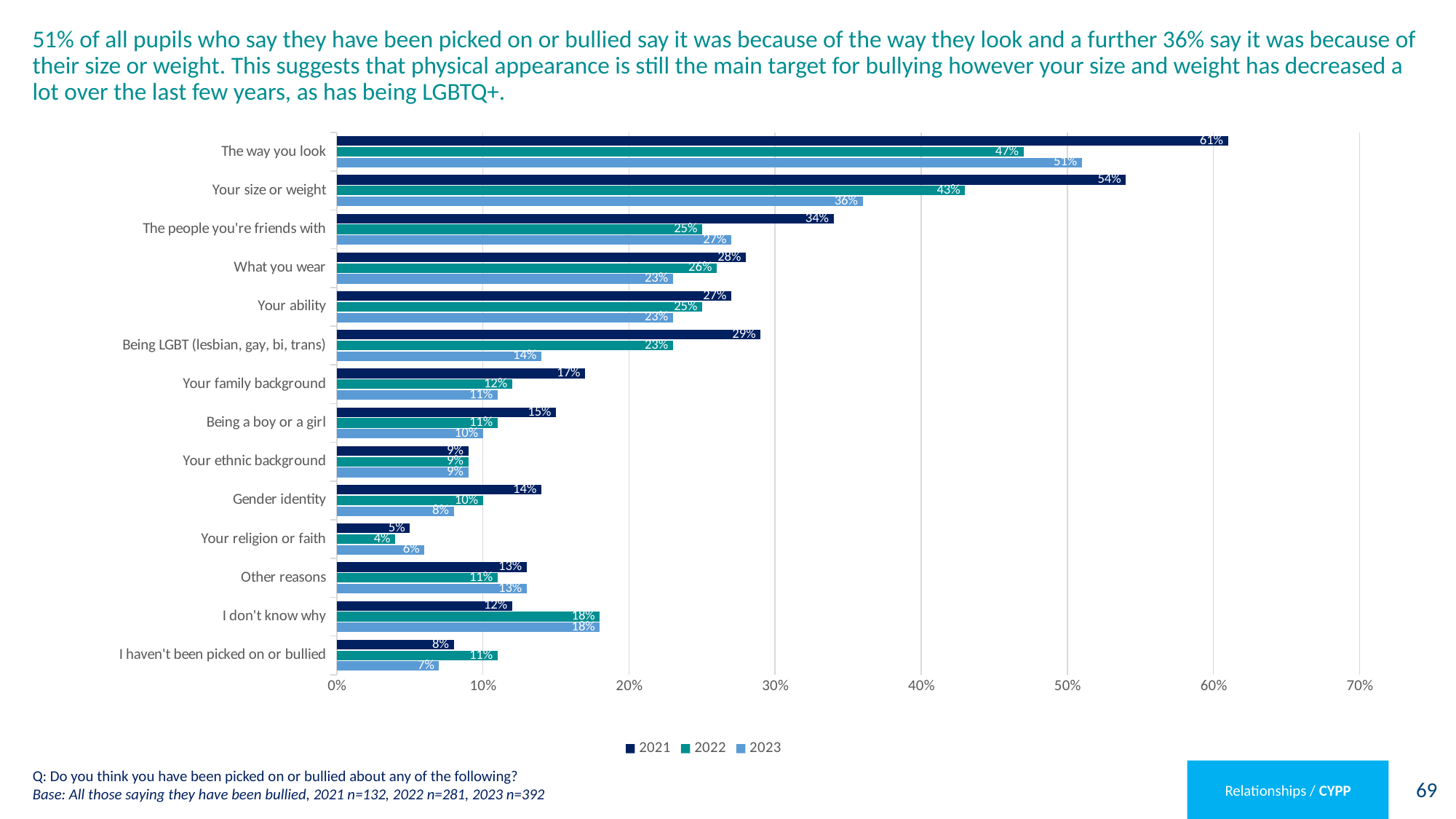
What kind of chart is shown on the slide? Bar chart Which category has the lowest 2022 value? Your religion or faith What is the 2023 value for "Your size or weight"? 36% What is the 2022 value for "I don't know why"? 18% How many series does the legend list? 3 What is the 2021 value for "Being LGBT (lesbian, gay, bi, trans)"? 29% Which category has the highest 2021 value? The way you look What is the 2023 value for "Your religion or faith"? 6% Which years are listed in the chart legend? 2021, 2022, 2023 What is the difference between the 2021 and 2023 values for "Being LGBT (lesbian, gay, bi, trans)"? 15% Which is larger for "The way you look": the 2022 value or the 2023 value? 2023 How many categories are shown on the chart? 14